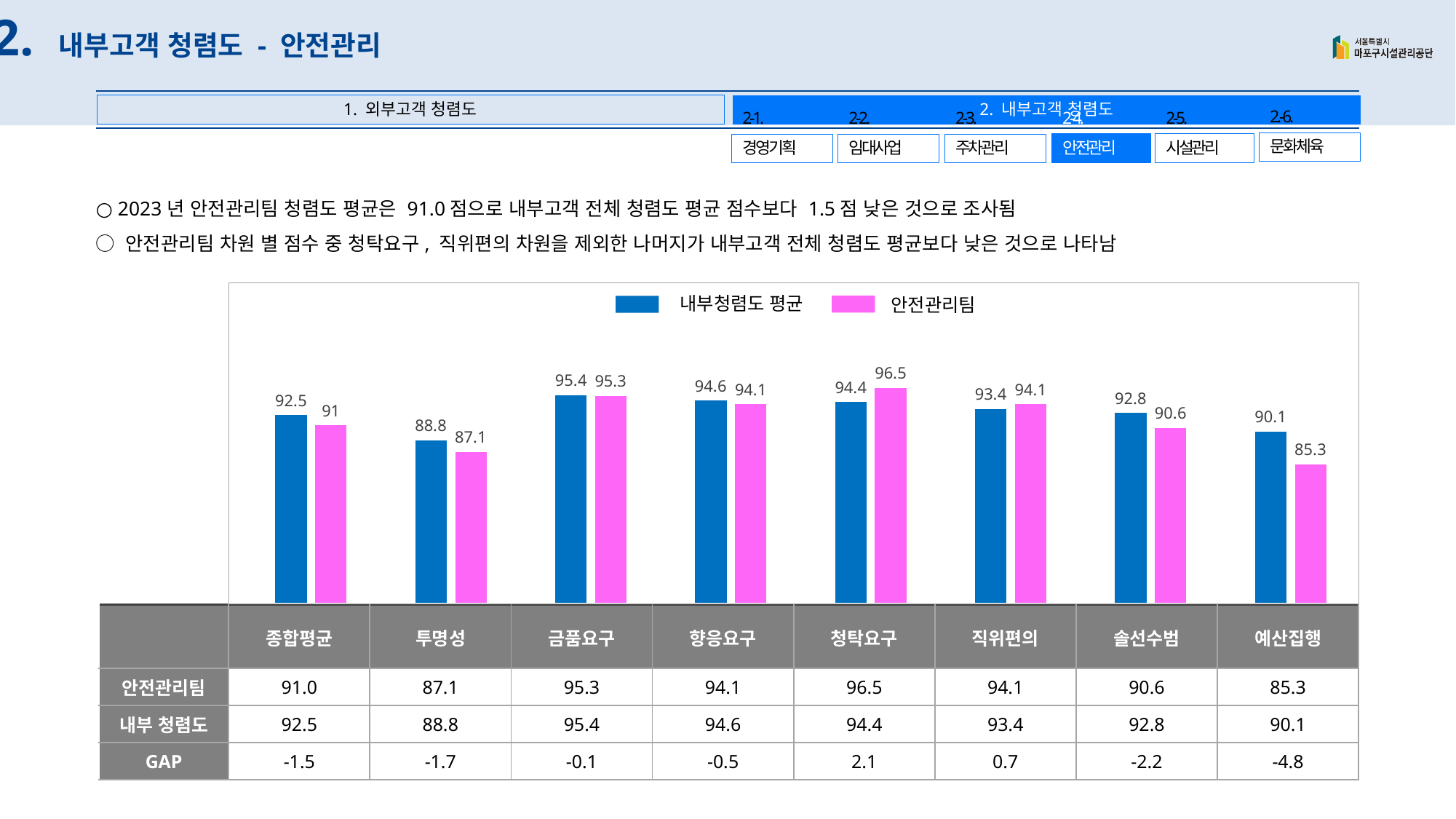
For 직위편의, which is larger: 내부청렴도 평균 or 안전관리팀? 안전관리팀 What is the value of 안전관리팀 for 예산집행? 85.3 What is the value of 내부청렴도 평균 for 투명성? 88.8 Which category has the highest 안전관리팀 value? 청탁요구 How many categories are shown on the x axis of the chart? 8 What is the value of 안전관리팀 for 청탁요구? 96.5 What kind of chart is shown on the slide? bar chart Which series is shown in pink in the chart? 안전관리팀 Which category has the lowest 안전관리팀 value? 예산집행 Which category has the lowest 내부청렴도 평균 value? 투명성 What is the difference between 내부청렴도 평균 and 안전관리팀 for 예산집행? 4.8 How many series does the chart legend list? 2